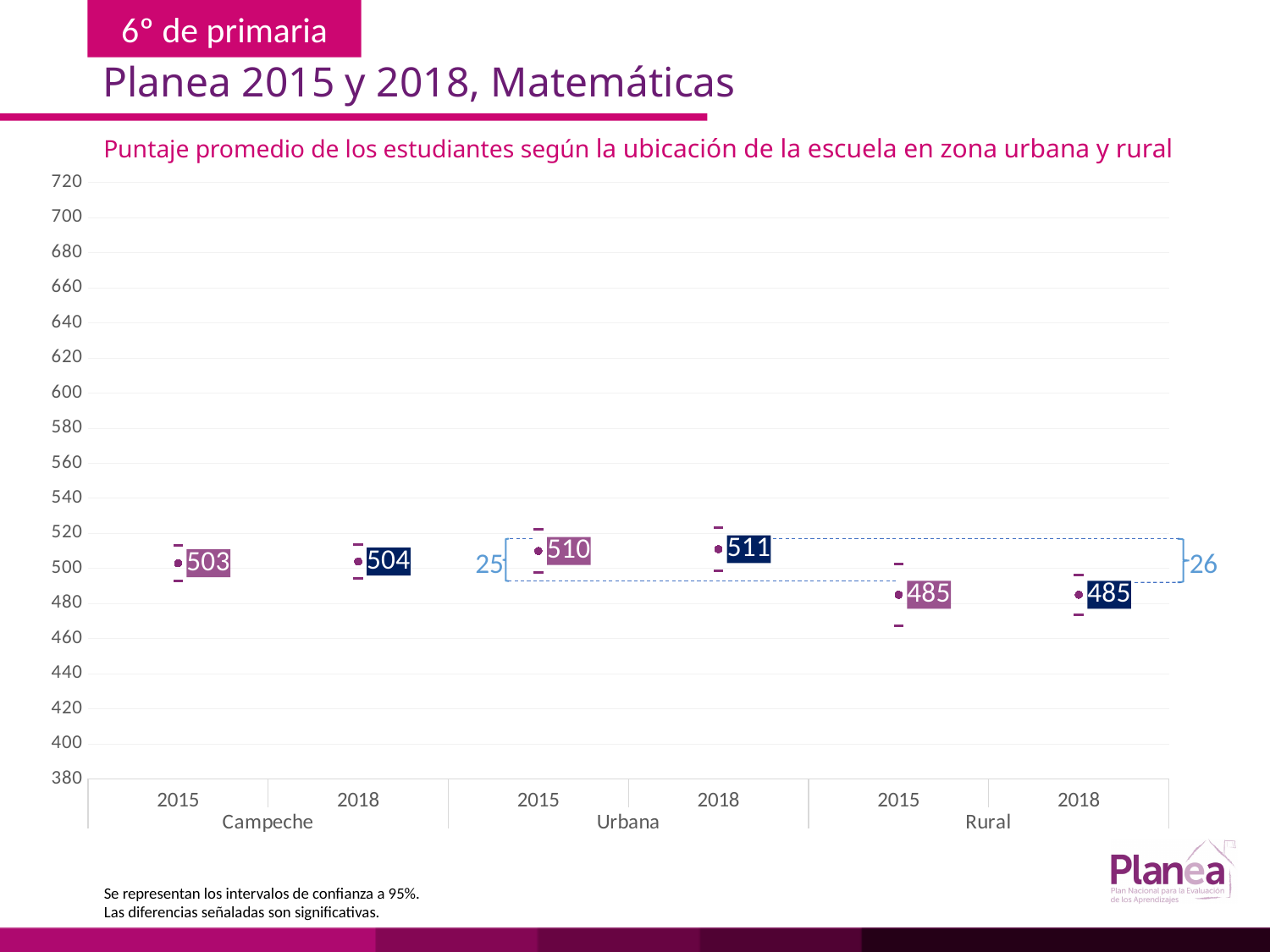
Which is larger, the Campeche 2018 score or the Rural 2018 score? Campeche 2018 What is the average score for Urbana schools in 2018? 511 What is the average score for Urbana schools in 2015? 510 Which group and year has the highest average score? Urbana 2018 What is the average score for Campeche in 2015? 503 What is the average score for Rural schools in 2018? 485 What is the difference between the Urbana and Rural average scores in 2015? 25 What is the title of the chart? Puntaje promedio de los estudiantes según la ubicación de la escuela en zona urbana y rural How many data points are plotted on the chart? 6 What is the average score for Campeche in 2018? 504 What is the difference between the Urbana and Rural average scores in 2018? 26 Is the Rural 2015 average score greater or less than 500? less